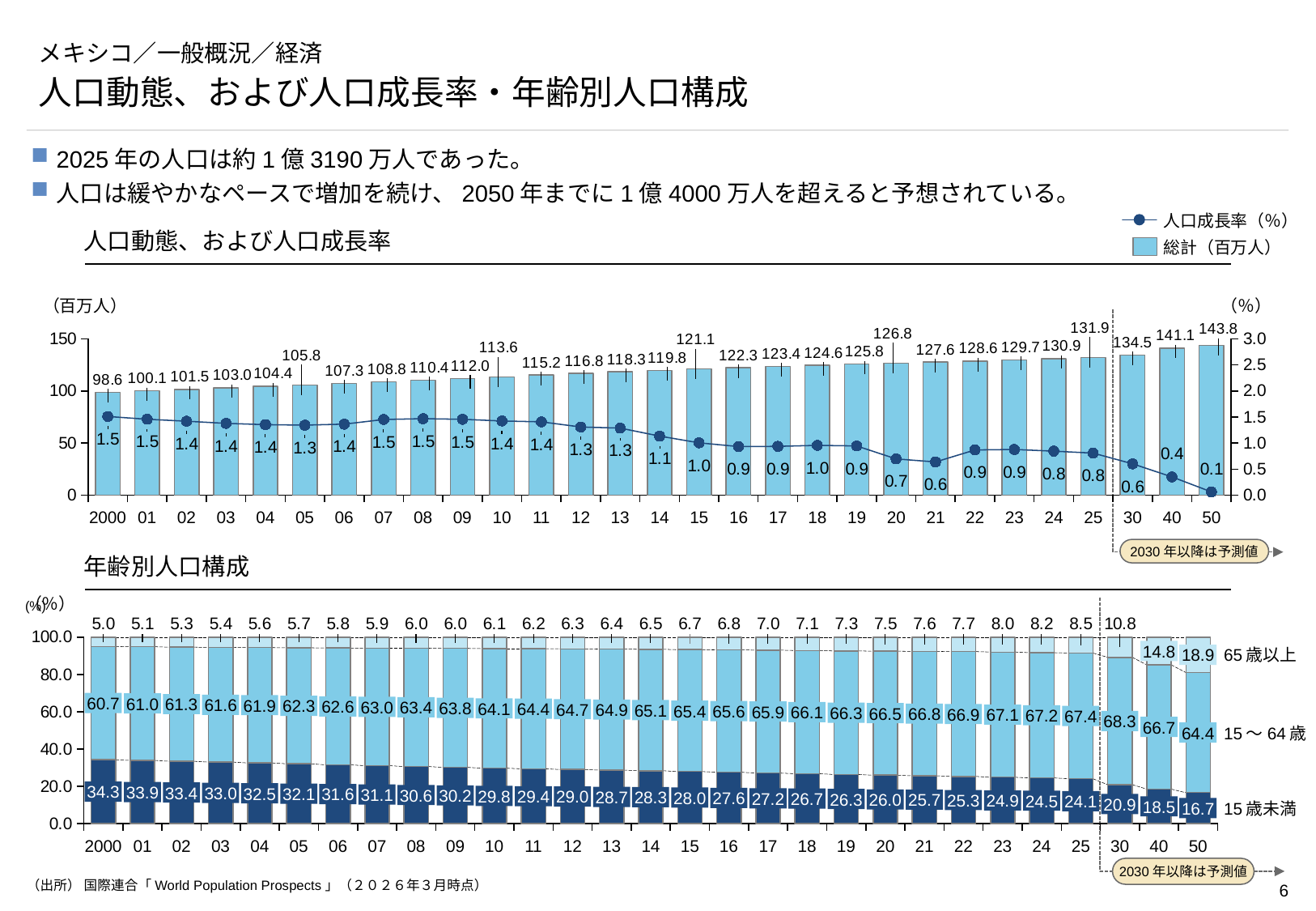
How many series does the legend of the top chart (人口動態、および人口成長率) list? 2 In the bottom chart (年齢別人口構成), what is the share of 65歳以上 in 2050? 18.9 In the top chart (人口動態、および人口成長率), what is the total population (百万人) shown for 2025? 131.9 In the bottom chart (年齢別人口構成), what is the share of 15歳未満 in 2000? 34.3 In the top chart (人口動態、および人口成長率), which year has the lowest population growth rate? 50 (2050) In the top chart (人口動態、および人口成長率), by how much does the total population in 2050 exceed that in 2000? 45.2 What kind of chart is the bottom chart (年齢別人口構成)? Stacked bar chart In the top chart (人口動態、および人口成長率), which year has the highest total population? 50 (2050) In the bottom chart (年齢別人口構成), does the share of 15歳未満 rise or fall from 2000 to 2050? Fall In the top chart (人口動態、および人口成長率), what is the population growth rate (%) shown for 2020? 0.7 In the top chart (人口動態、および人口成長率), which year has the higher population growth rate, 2007 or 2021? 2007 In the bottom chart (年齢別人口構成), how much larger is the 15～64歳 share in 2025 than in 2000? 6.7